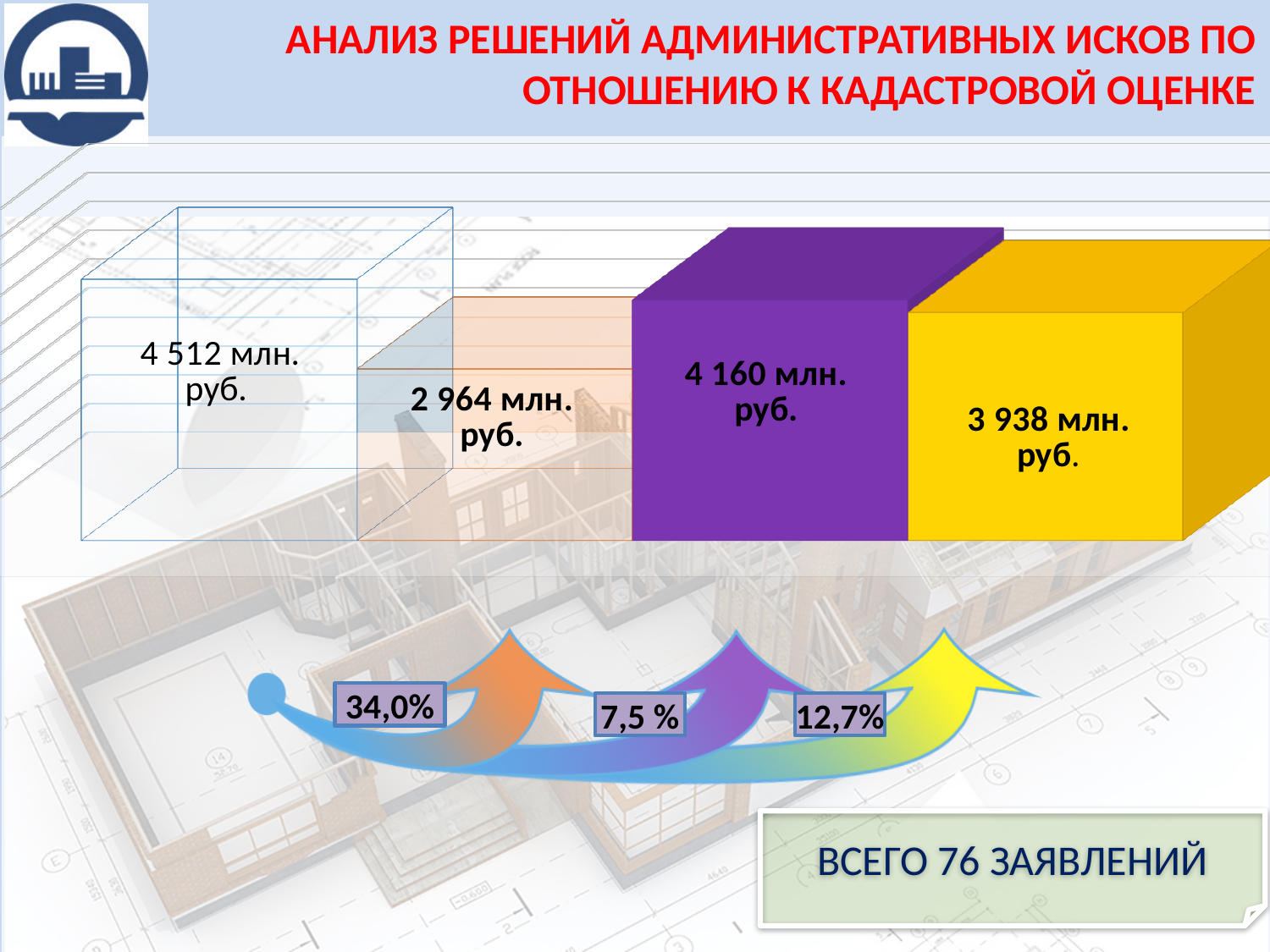
What value is printed on the purple bar of the chart? 4 160 млн. руб. Which bar shows the highest value on the chart? The leftmost outlined bar (4 512 млн. руб.) What value is printed on the second bar from the left (the orange translucent bar)? 2 964 млн. руб. What value is printed on the leftmost (outlined, transparent) bar of the chart? 4 512 млн. руб. Which bar shows the lowest value on the chart? The second bar from the left, orange (2 964 млн. руб.) What is the difference between the value on the purple bar and the value on the yellow bar? 222 млн. руб. Which is larger: the value on the purple bar or the value on the yellow bar? The purple bar (4 160 млн. руб.) What value is printed on the yellow bar of the chart? 3 938 млн. руб. What total number of applications is stated in the box at the bottom right of the slide? 76 заявлений What is the difference between the leftmost bar's value and the orange bar's value? 1 548 млн. руб. What kind of chart is shown on the slide? Bar chart How many bars are shown on the chart? 4